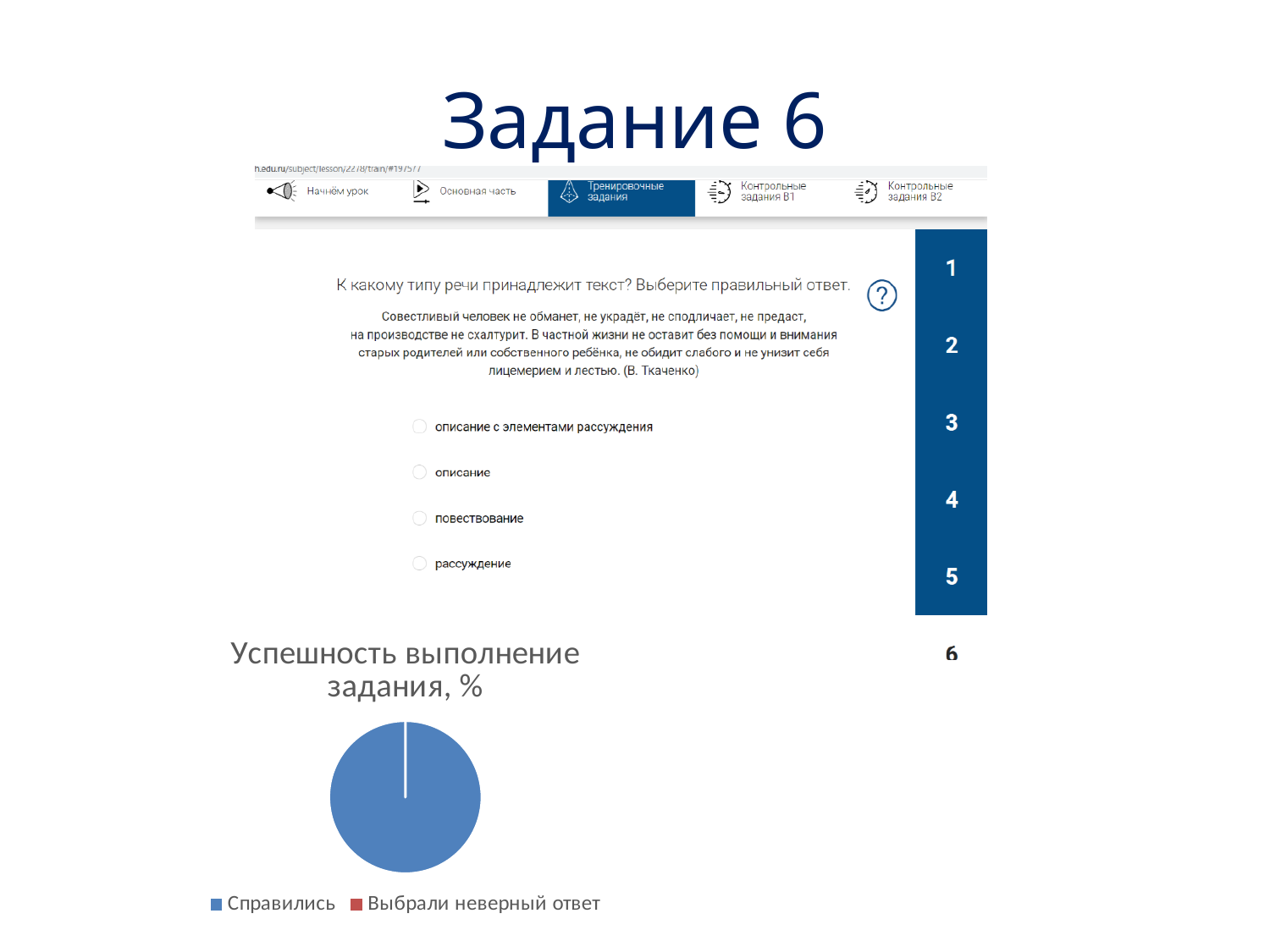
Which is larger in the pie chart: Справились or Выбрали неверный ответ? Справились How many entries does the chart's legend list? 2 Is the share for Выбрали неверный ответ greater or less than 50%? less What kind of chart is shown on the slide? pie chart Which category takes up the largest share of the pie? Справились What is the title of the chart on the slide? Успешность выполнение задания, % Which category takes up the smallest share of the pie? Выбрали неверный ответ What colour represents Справились in the chart legend? blue Is the share for Справились greater or less than 50%? greater